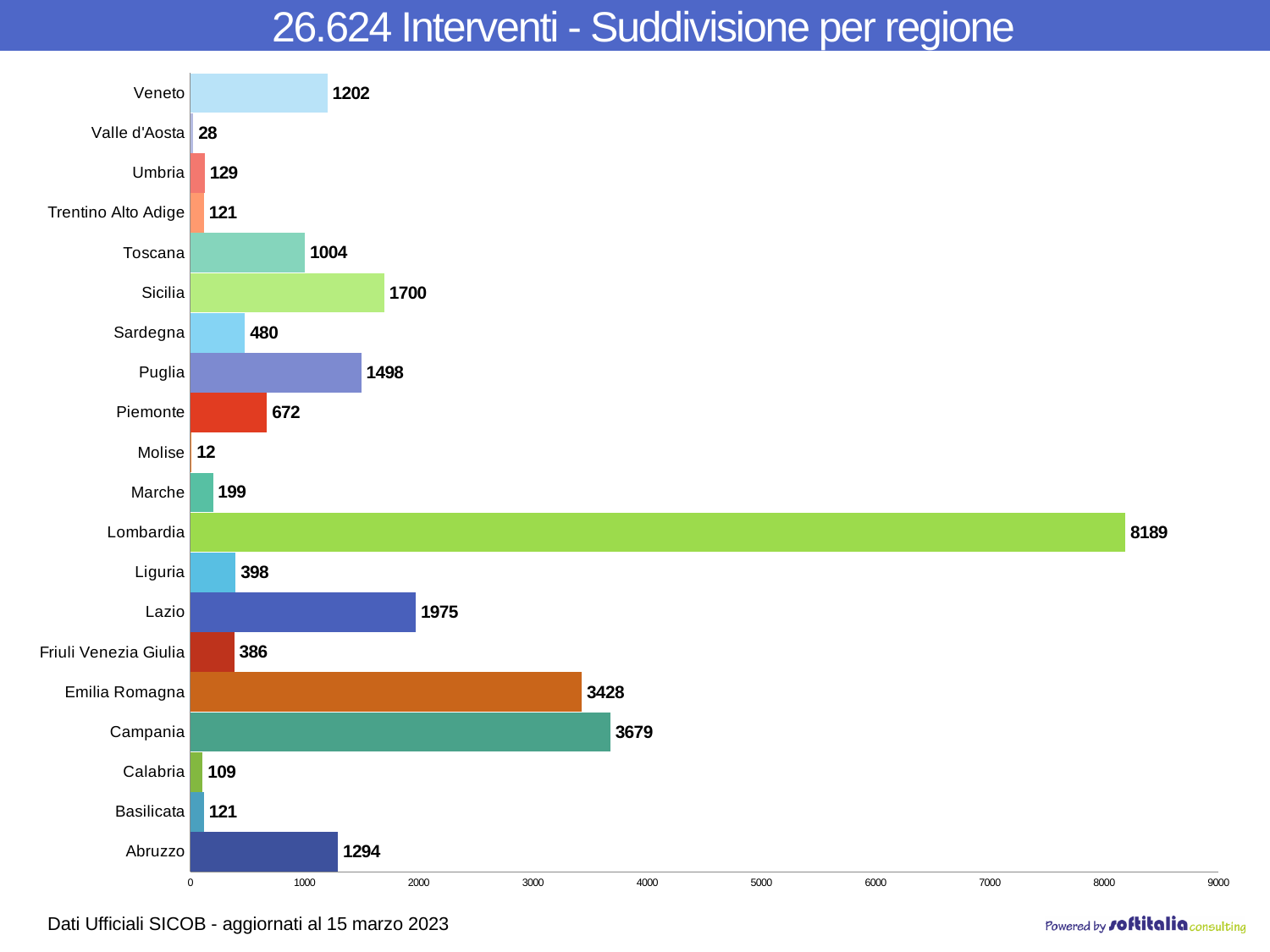
What is the value for Emilia Romagna? 3428 How many regions are shown in the chart? 20 What is the difference between the values for Veneto and Toscana? 198 What is the value for Valle d'Aosta? 28 What kind of chart is shown on the slide? Bar chart Which is larger, the value for Lazio or the value for Sicilia? Lazio Is the value for Puglia greater or less than 1000? greater Which region has the lowest value? Molise What is the title of the chart? 26.624 Interventi - Suddivisione per regione What is the value for Lombardia? 8189 What is the difference between the values for Campania and Emilia Romagna? 251 Which region has the highest value? Lombardia